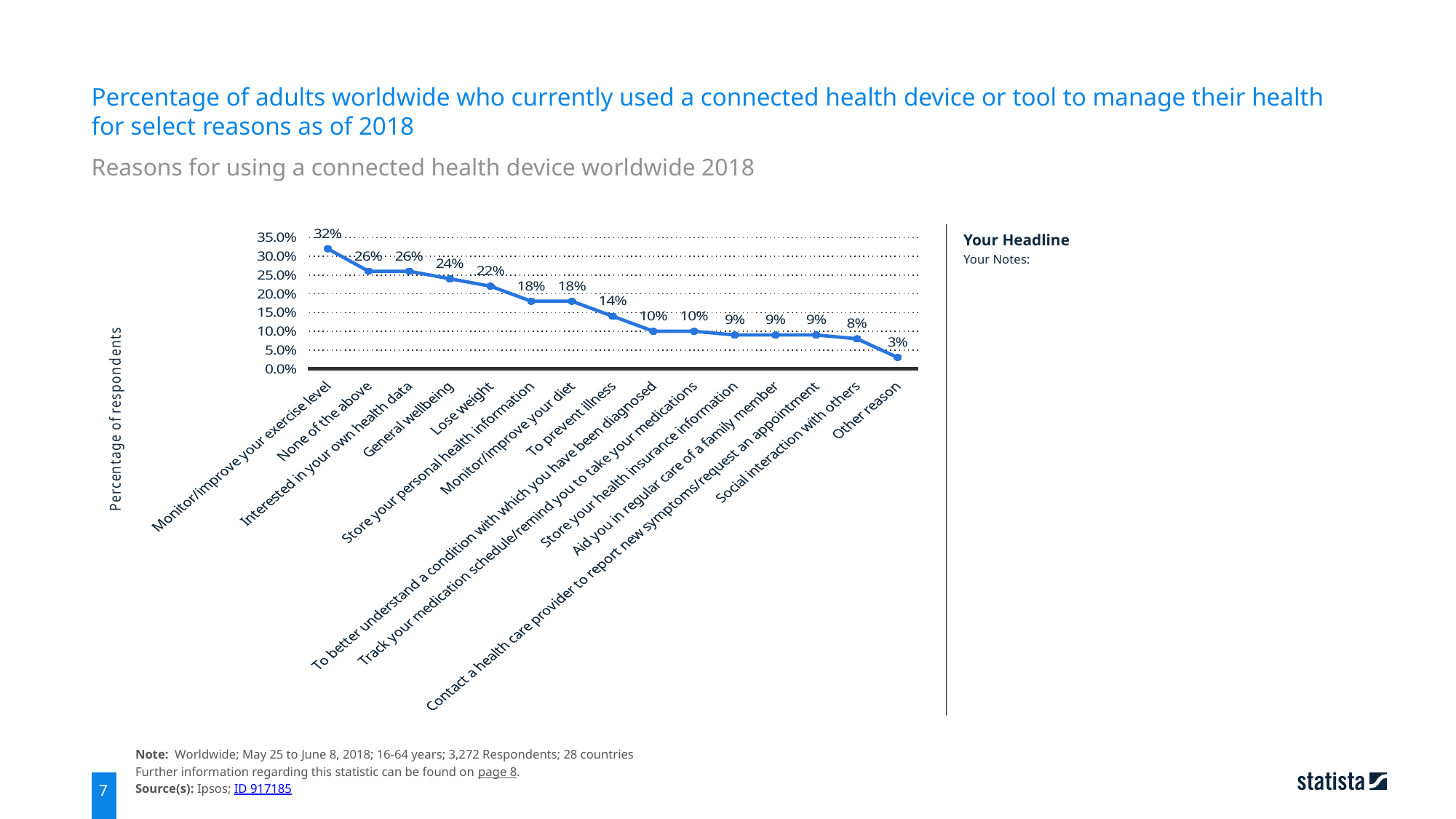
What is the value for 'Social interaction with others'? 8% What percentage of respondents used a connected health device to monitor/improve their exercise level? 32% What is the value for 'To prevent illness'? 14% What is the difference between the values for 'Monitor/improve your exercise level' and 'General wellbeing'? 8% Which category has the lowest percentage of respondents? Other reason Which reason has the highest percentage of respondents? Monitor/improve your exercise level What kind of chart is shown on the slide? Line chart What is the label of the vertical axis? Percentage of respondents How many reasons (categories) are plotted on the chart? 15 What is the value for 'Lose weight'? 22% Do the values rise or fall moving from left to right along the x axis? Fall Which is larger, the value for 'Lose weight' or the value for 'To prevent illness'? Lose weight